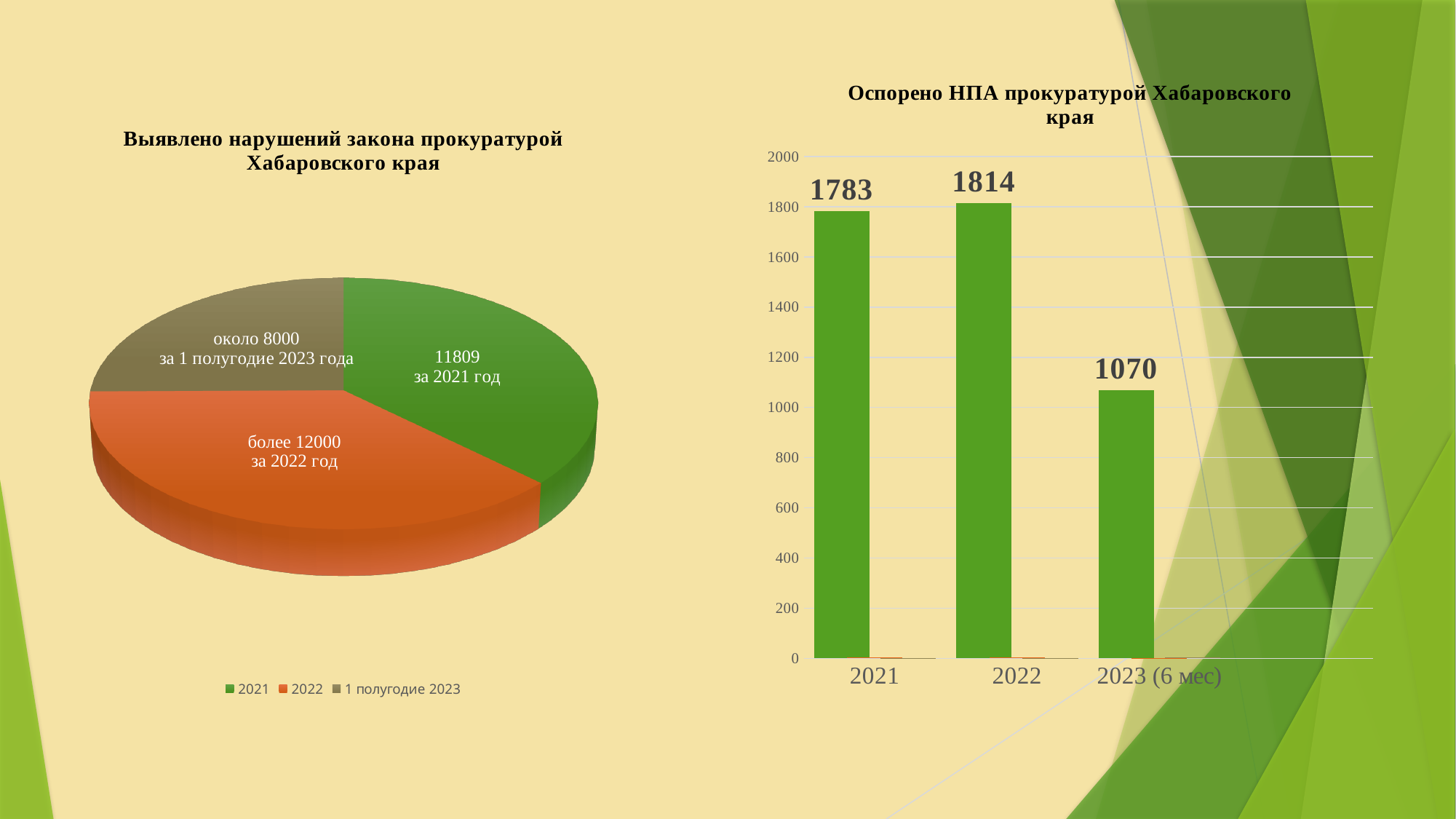
In the pie chart 'Выявлено нарушений закона прокуратурой Хабаровского края', which slice is the largest? 2022 In the pie chart 'Выявлено нарушений закона прокуратурой Хабаровского края', how many entries does the legend list? 3 In the bar chart 'Оспорено НПА прокуратурой Хабаровского края', what is the value for 2023 (6 мес)? 1070 In the bar chart 'Оспорено НПА прокуратурой Хабаровского края', how many categories are shown on the x axis? 3 In the bar chart 'Оспорено НПА прокуратурой Хабаровского края', which category has the highest value? 2022 What kind of chart is the chart titled 'Оспорено НПА прокуратурой Хабаровского края'? bar chart In the bar chart 'Оспорено НПА прокуратурой Хабаровского края', what is the difference between the values for 2022 and 2021? 31 In the bar chart 'Оспорено НПА прокуратурой Хабаровского края', what is the difference between the values for 2021 and 2023 (6 мес)? 713 In the bar chart 'Оспорено НПА прокуратурой Хабаровского края', which category has the lowest value? 2023 (6 мес) In the bar chart 'Оспорено НПА прокуратурой Хабаровского края', what is the value for 2021? 1783 In the pie chart 'Выявлено нарушений закона прокуратурой Хабаровского края', what value is printed for 2021? 11809 In the bar chart 'Оспорено НПА прокуратурой Хабаровского края', what is the value for 2022? 1814